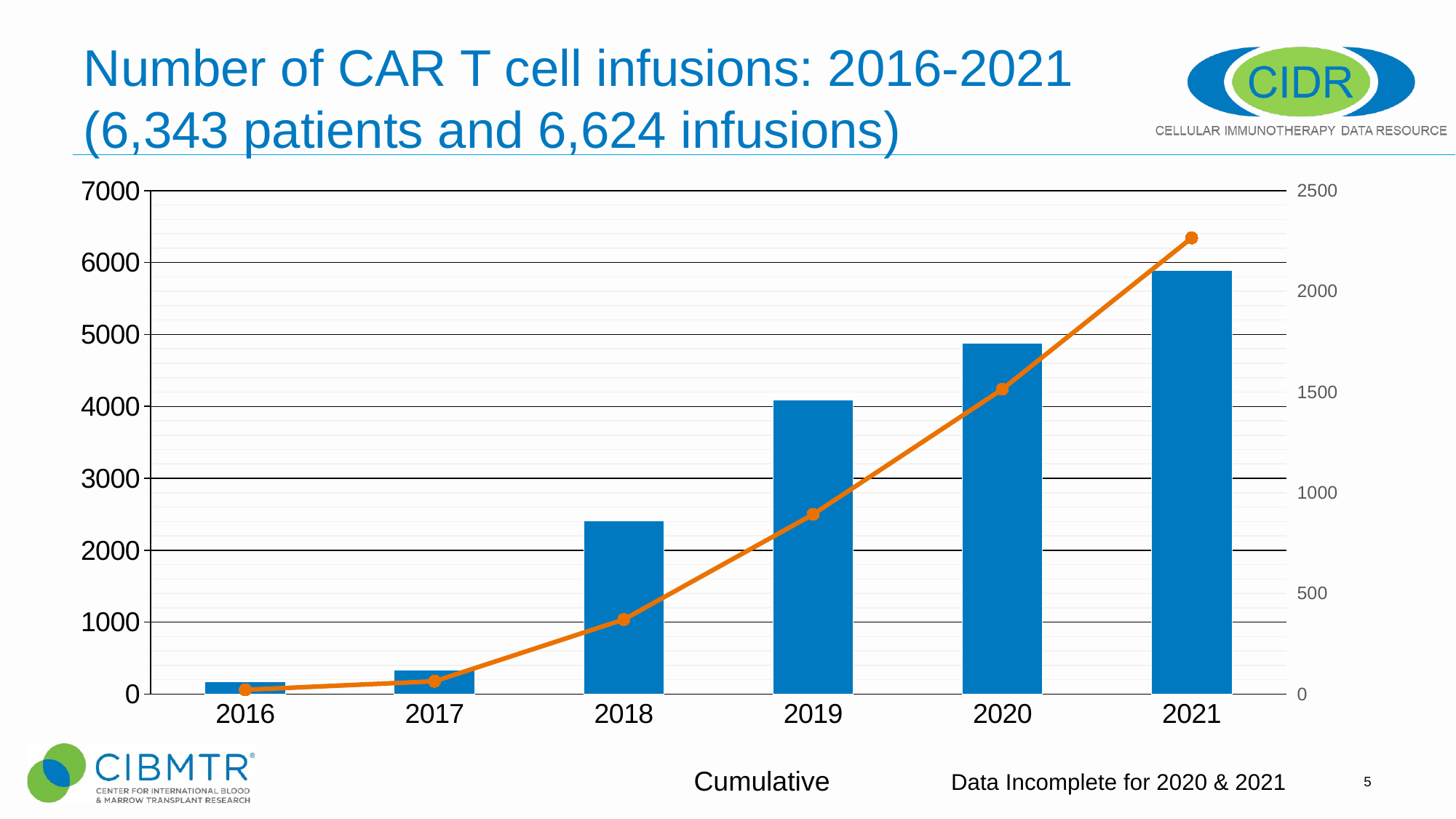
Which bar is taller, 2018 or 2019? 2019 What is the highest tick value shown on the right vertical axis? 2500 Is the bar for 2018 greater or less than 2000 on the left axis? greater What kind of chart is shown on the slide? A bar chart with a line overlay Which year has the tallest bar in the chart? 2021 Is the bar for 2021 greater or less than 5000 on the left axis? greater How many years are shown along the x axis of the chart? 6 What is the highest tick value shown on the left vertical axis? 7000 Do the bar values rise or fall from 2016 to 2021? rise Is the bar for 2020 greater or less than 4000 on the left axis? greater Which year has the shortest bar in the chart? 2016